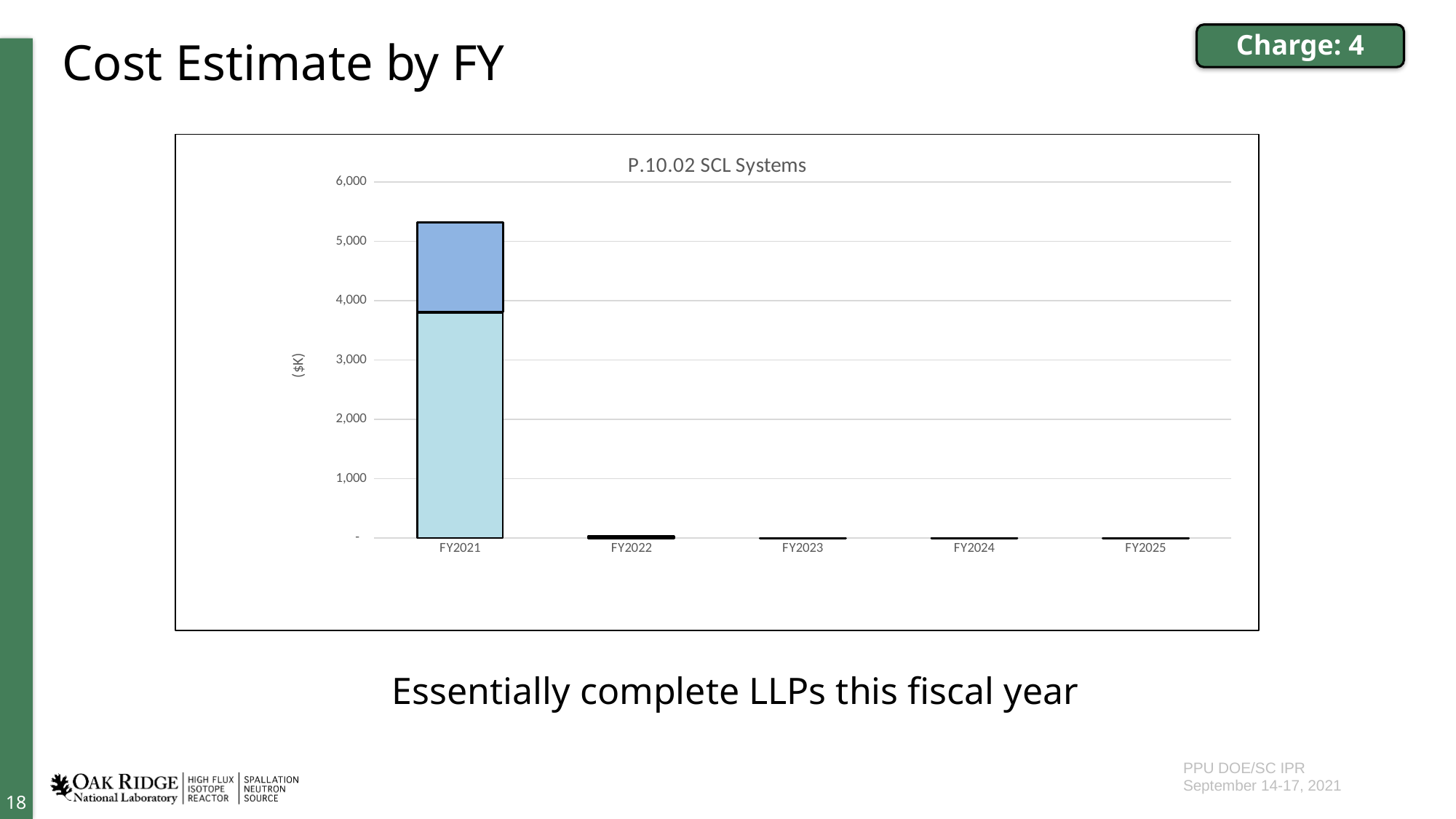
Which fiscal year has the highest total cost estimate in the chart? FY2021 Do the values rise or fall from FY2021 to FY2022 along the x axis? fall Which is larger, the value for FY2021 or the value for FY2022? FY2021 Is the total value of the FY2021 bar greater or less than 5,000? greater What is the label on the vertical axis of the chart? ($K) Is the total value of the FY2021 bar greater or less than 6,000? less Is the value of the lower (light blue) segment of the FY2021 bar greater or less than 4,000? less How many fiscal years are shown on the x axis of the chart? 5 What is the title of the chart? P.10.02 SCL Systems What kind of chart is shown on the slide? bar chart